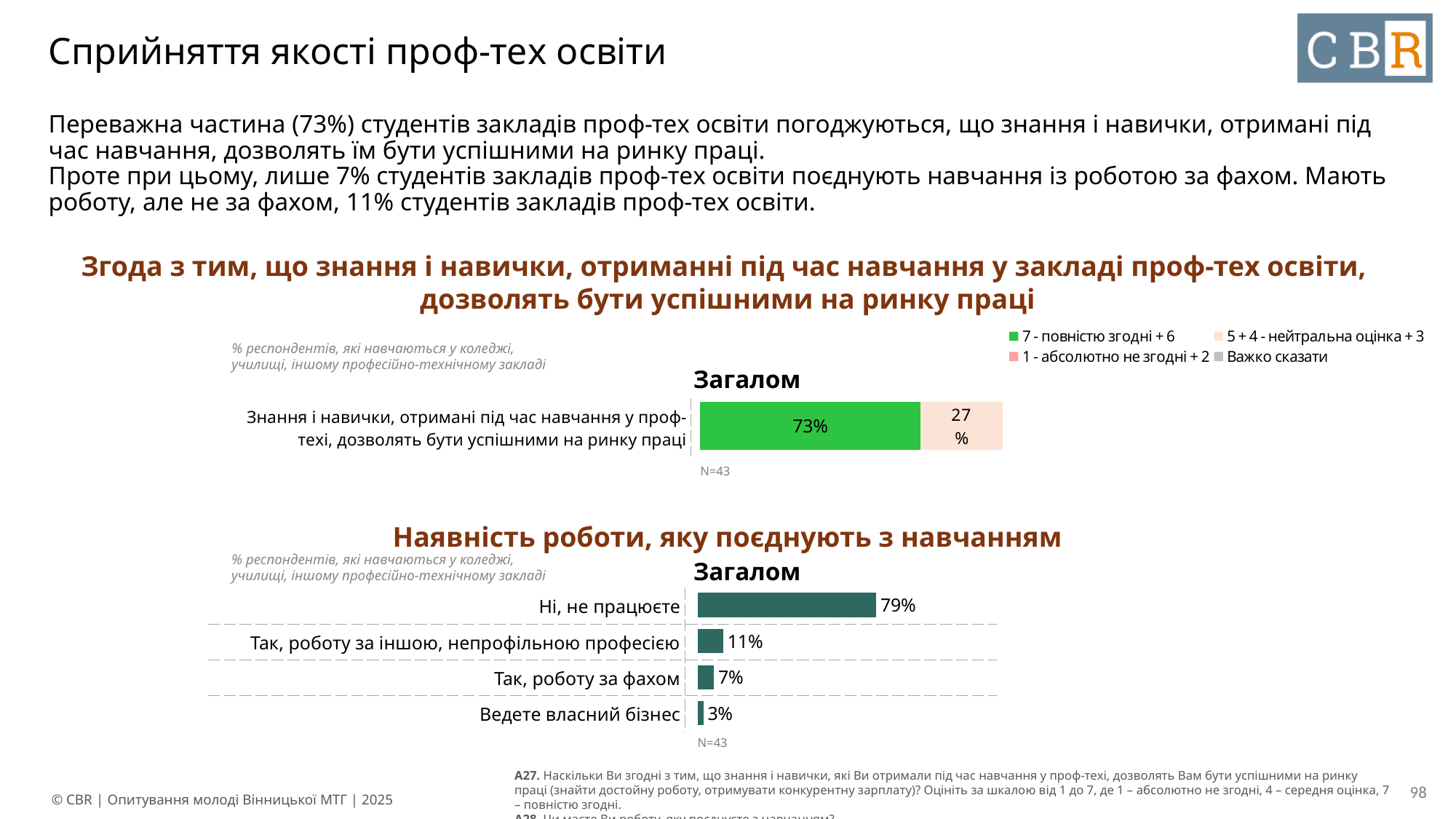
In the bottom chart ("Наявність роботи, яку поєднують з навчанням"), what is the difference between "Так, роботу за іншою, непрофільною професією" and "Так, роботу за фахом"? 4 percentage points In the bottom chart ("Наявність роботи, яку поєднують з навчанням"), what is the value for "Так, роботу за фахом"? 7% In the bottom chart ("Наявність роботи, яку поєднують з навчанням"), which category has the highest value? Ні, не працюєте In the top chart ("Згода з тим, що знання і навички..."), how many series does the legend list? 4 In the top chart ("Згода з тим, що знання і навички..."), what share of respondents chose "5 + 4 - нейтральна оцінка + 3"? 27% In the bottom chart ("Наявність роботи, яку поєднують з навчанням"), what is the value for "Ні, не працюєте"? 79% In the top chart ("Згода з тим, що знання і навички..."), what is the difference between the "7 - повністю згодні + 6" segment and the "5 + 4 - нейтральна оцінка + 3" segment? 46 percentage points In the top chart ("Згода з тим, що знання і навички..."), what share of respondents chose "7 - повністю згодні + 6"? 73% In the top chart ("Згода з тим, що знання і навички..."), what is the total of the two labelled segments of the stacked bar? 100% In the bottom chart ("Наявність роботи, яку поєднують з навчанням"), how many categories are shown? 4 In the bottom chart ("Наявність роботи, яку поєднують з навчанням"), which category has the lowest value? Ведете власний бізнес What kind of chart is the bottom chart ("Наявність роботи, яку поєднують з навчанням")? Bar chart